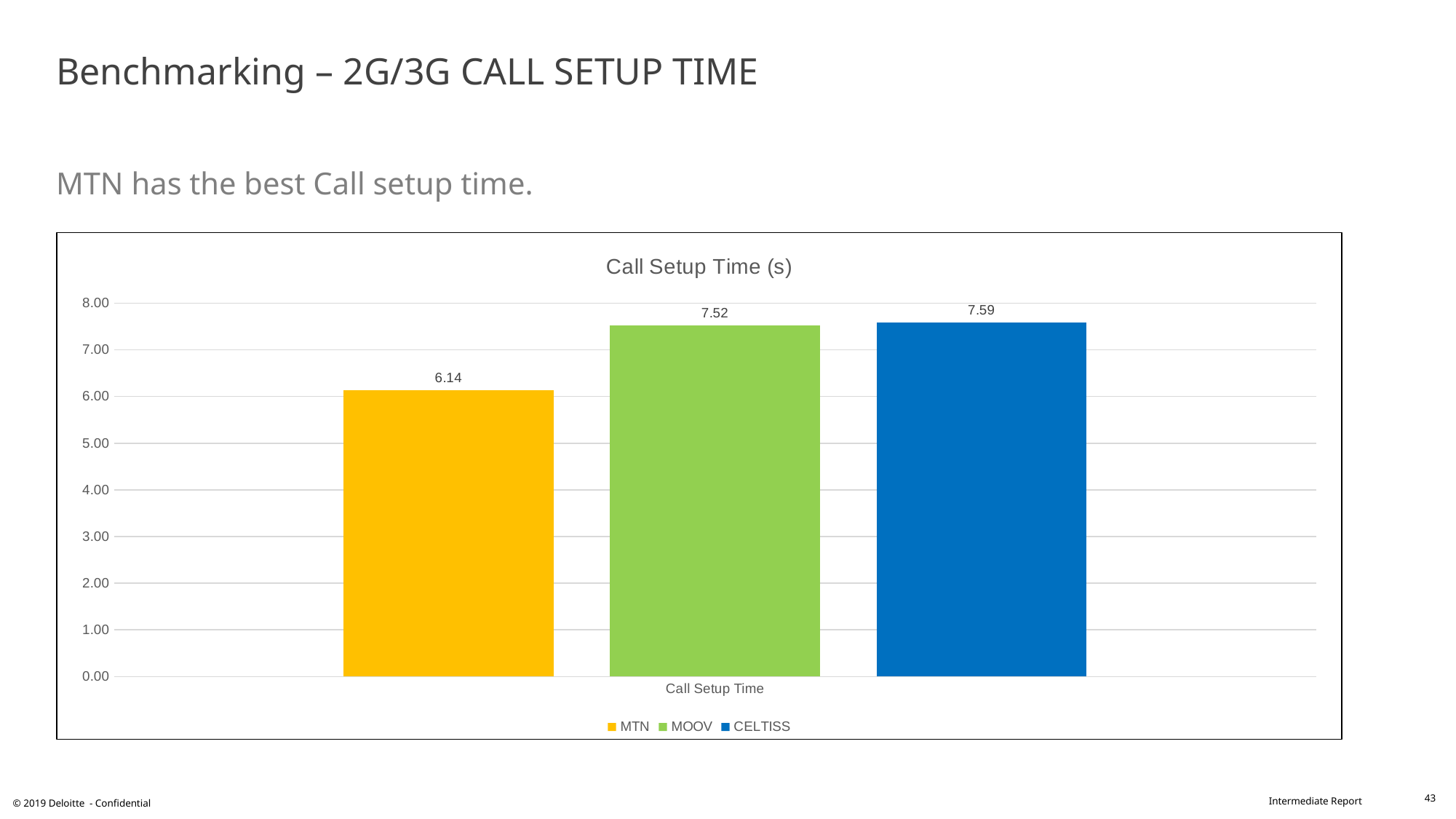
Is the call setup time for MTN greater or less than 6.00? greater What is the difference between the call setup times of CELTISS and MTN? 1.45 Which operator has the highest call setup time? CELTISS Which has a larger call setup time, MTN or MOOV? MOOV What is the call setup time for CELTISS? 7.59 What kind of chart is shown on the slide? Bar chart What is the call setup time for MOOV? 7.52 How many series does the legend list? 3 What is the title of the chart? Call Setup Time (s) What is the difference between the call setup times of MOOV and MTN? 1.38 What is the call setup time for MTN? 6.14 Which operator has the lowest call setup time? MTN